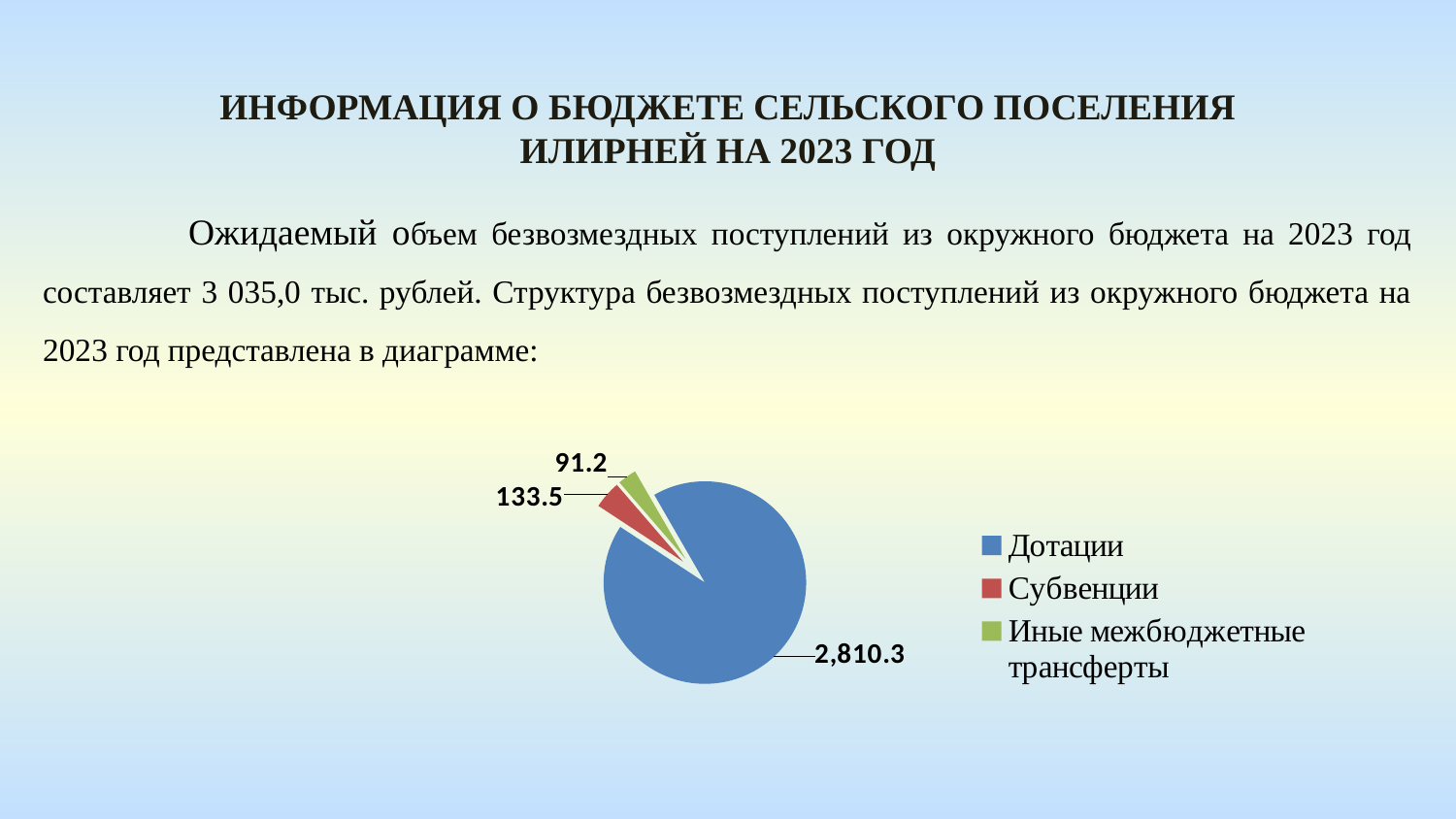
What is the total of all three slices in the pie chart? 3,035.0 Which is larger, Субвенции or Иные межбюджетные трансферты? Субвенции How many slices does the pie chart have? 3 Which category has the smallest slice in the pie chart? Иные межбюджетные трансферты Which category has the largest slice in the pie chart? Дотации What is the difference between the Субвенции value and the Иные межбюджетные трансферты value? 42.3 What is the value of the Иные межбюджетные трансферты slice in the pie chart? 91.2 What type of chart is shown on the slide? Pie chart What is the difference between the Дотации value and the Субвенции value? 2,676.8 What is the value of the Дотации slice in the pie chart? 2,810.3 What colour is the Субвенции slice in the pie chart? Red What is the value of the Субвенции slice in the pie chart? 133.5